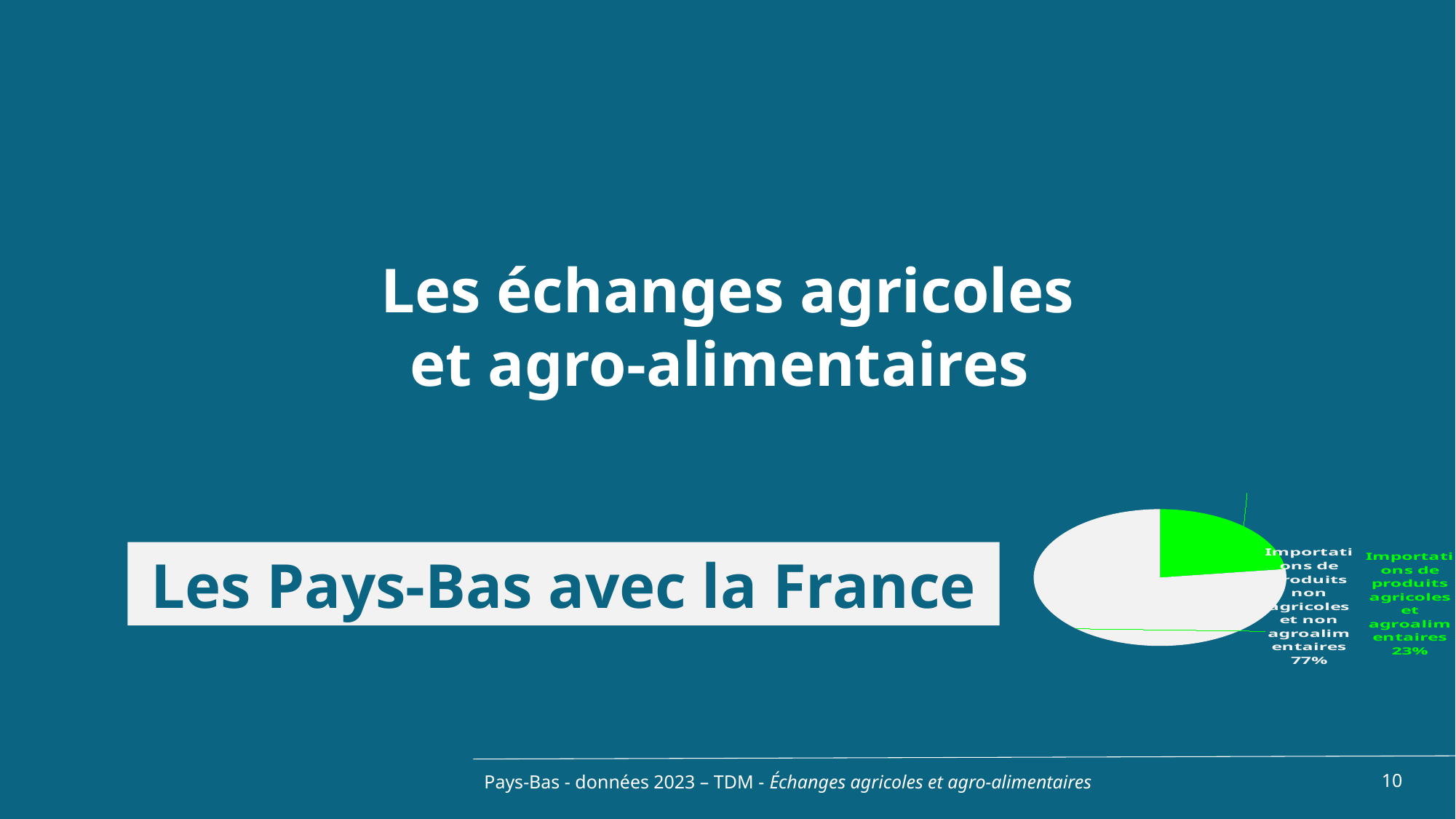
What is the difference in percentage points between the two slices of the pie chart? 54 Which slice of the pie chart is the largest? Importations de produits non agricoles et non agroalimentaires What share of the pie chart is labelled 'Importations de produits agricoles et agroalimentaires'? 23% Which slice of the pie chart is the smallest? Importations de produits agricoles et agroalimentaires Which is larger in the pie chart: the share of agricultural and agri-food imports or the share of non-agricultural and non-agri-food imports? Importations de produits non agricoles et non agroalimentaires Is the share of 'Importations de produits agricoles et agroalimentaires' in the pie chart greater or less than 50%? less What share of the pie chart is labelled 'Importations de produits non agricoles et non agroalimentaires'? 77% How many slices does the pie chart have? 2 What colour is the slice for 'Importations de produits agricoles et agroalimentaires' in the pie chart? Green What type of chart is shown on the slide? Pie chart